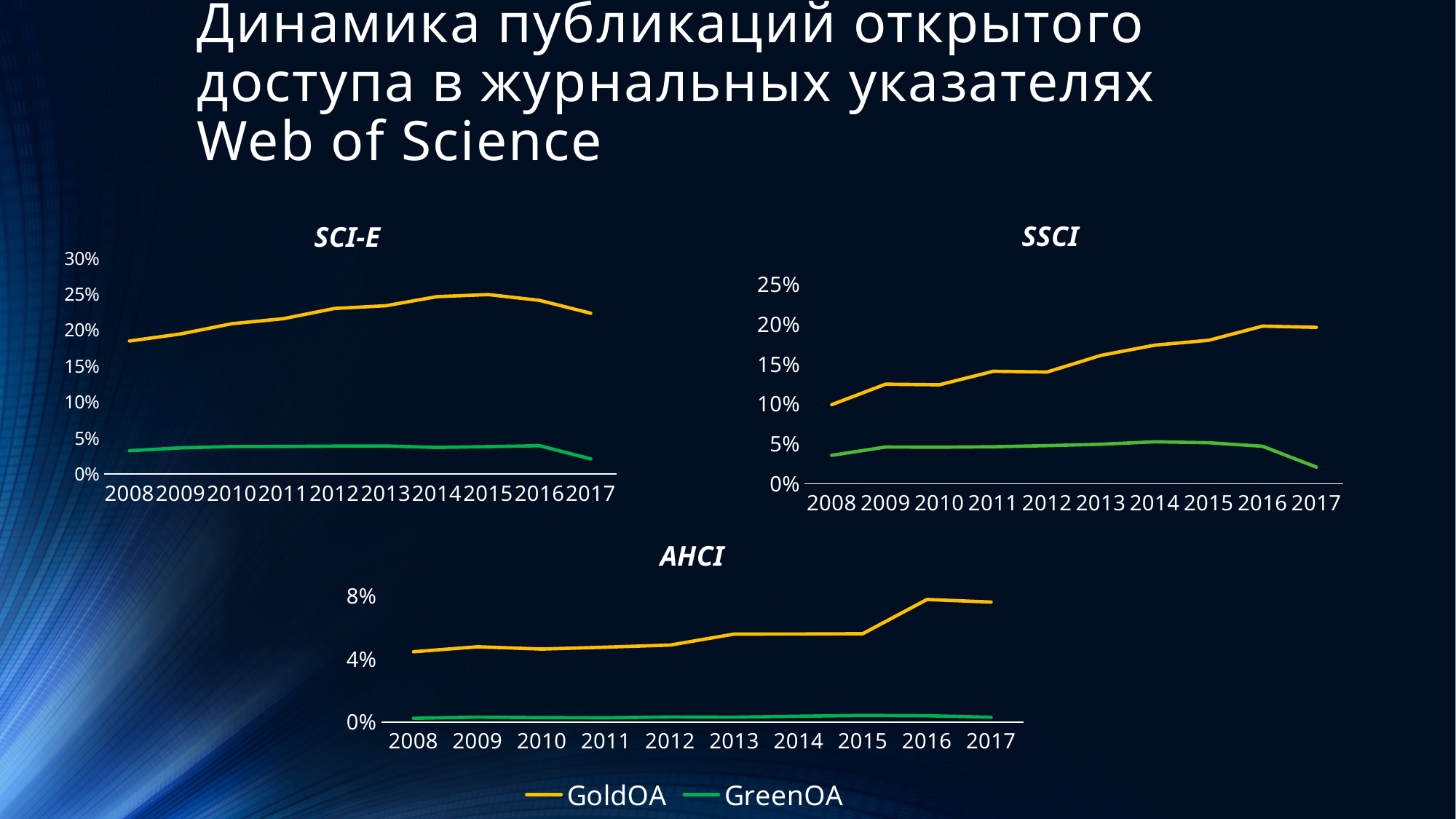
In the SSCI chart, which series is larger in 2016, GoldOA or GreenOA? GoldOA How many years are shown on the x axis of the AHCI chart? 10 In the SSCI chart, does the GoldOA line generally rise or fall from 2008 to 2016? rise In the SSCI chart, which year has the lowest GreenOA value? 2017 In the SSCI chart, is the GoldOA value for 2013 greater or less than 15%? greater In the SCI-E chart, is the GoldOA value for 2008 greater or less than 20%? less What kind of chart is the SCI-E chart? line chart Which series is shown in green in the legend? GreenOA In the AHCI chart, is the GoldOA value for 2015 greater or less than 8%? less In the SCI-E chart, which year has the highest GoldOA value? 2015 In the SCI-E chart, which year has the lowest GoldOA value? 2008 How many series does the legend list? 2